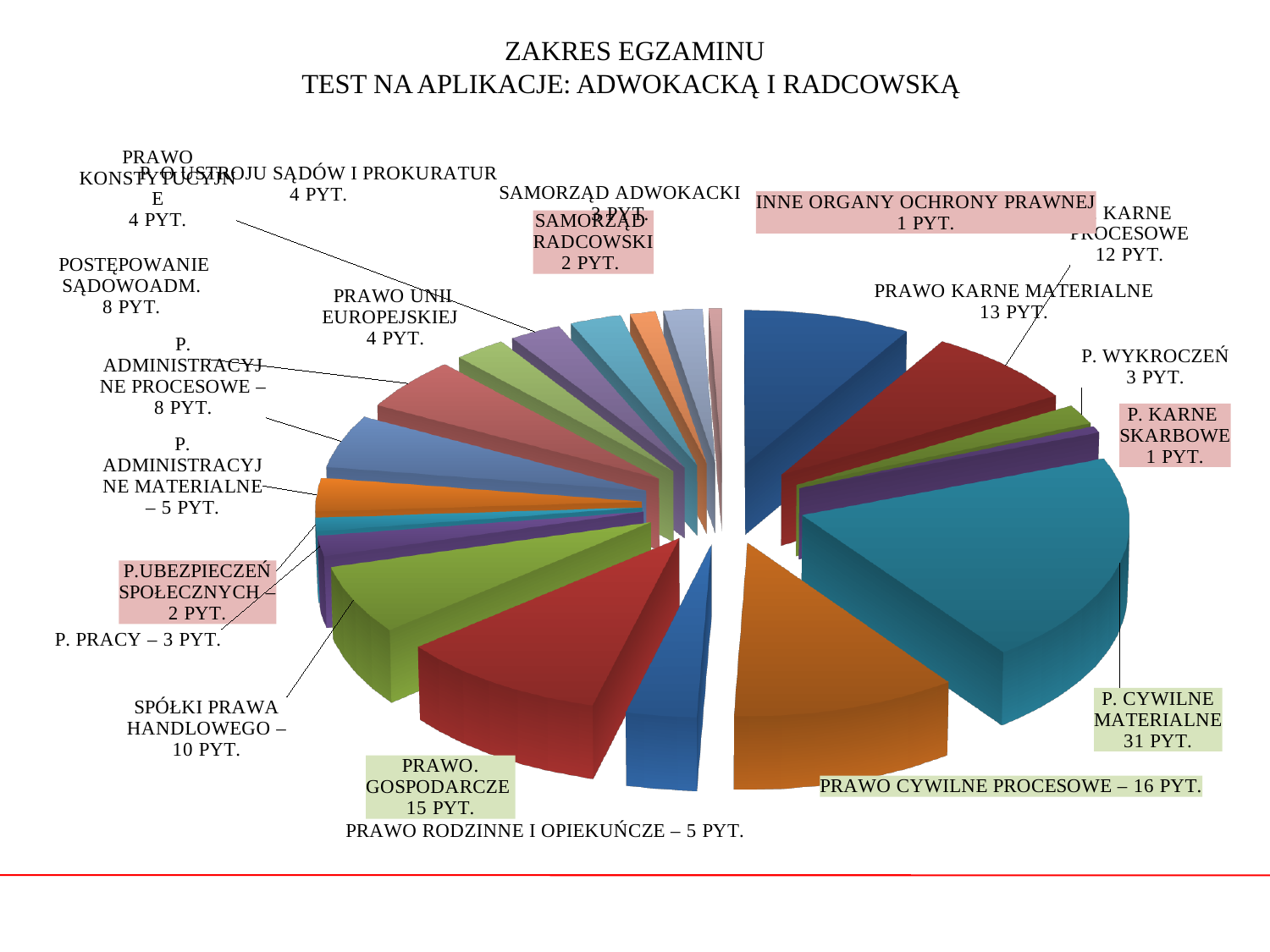
Which category has the largest number of questions? P. CYWILNE MATERIALNE How many questions (PYT.) are allocated to P. CYWILNE MATERIALNE? 31 PYT. How many questions are allocated to SPÓŁKI PRAWA HANDLOWEGO? 10 PYT. How many categories are labelled on the pie chart? 20 How many questions are allocated to PRAWO UNII EUROPEJSKIEJ? 4 PYT. What type of chart is shown on the slide? Pie chart What is the title of the slide above the chart? ZAKRES EGZAMINU TEST NA APLIKACJE: ADWOKACKĄ I RADCOWSKĄ Which has more questions, PRAWO KARNE MATERIALNE or P. KARNE PROCESOWE? PRAWO KARNE MATERIALNE What is the difference in the number of questions between P. CYWILNE MATERIALNE and PRAWO CYWILNE PROCESOWE? 15 How many questions are allocated to PRAWO KARNE MATERIALNE? 13 PYT. Which has more questions, PRAWO GOSPODARCZE or SPÓŁKI PRAWA HANDLOWEGO? PRAWO GOSPODARCZE How many questions are allocated to PRAWO GOSPODARCZE? 15 PYT.